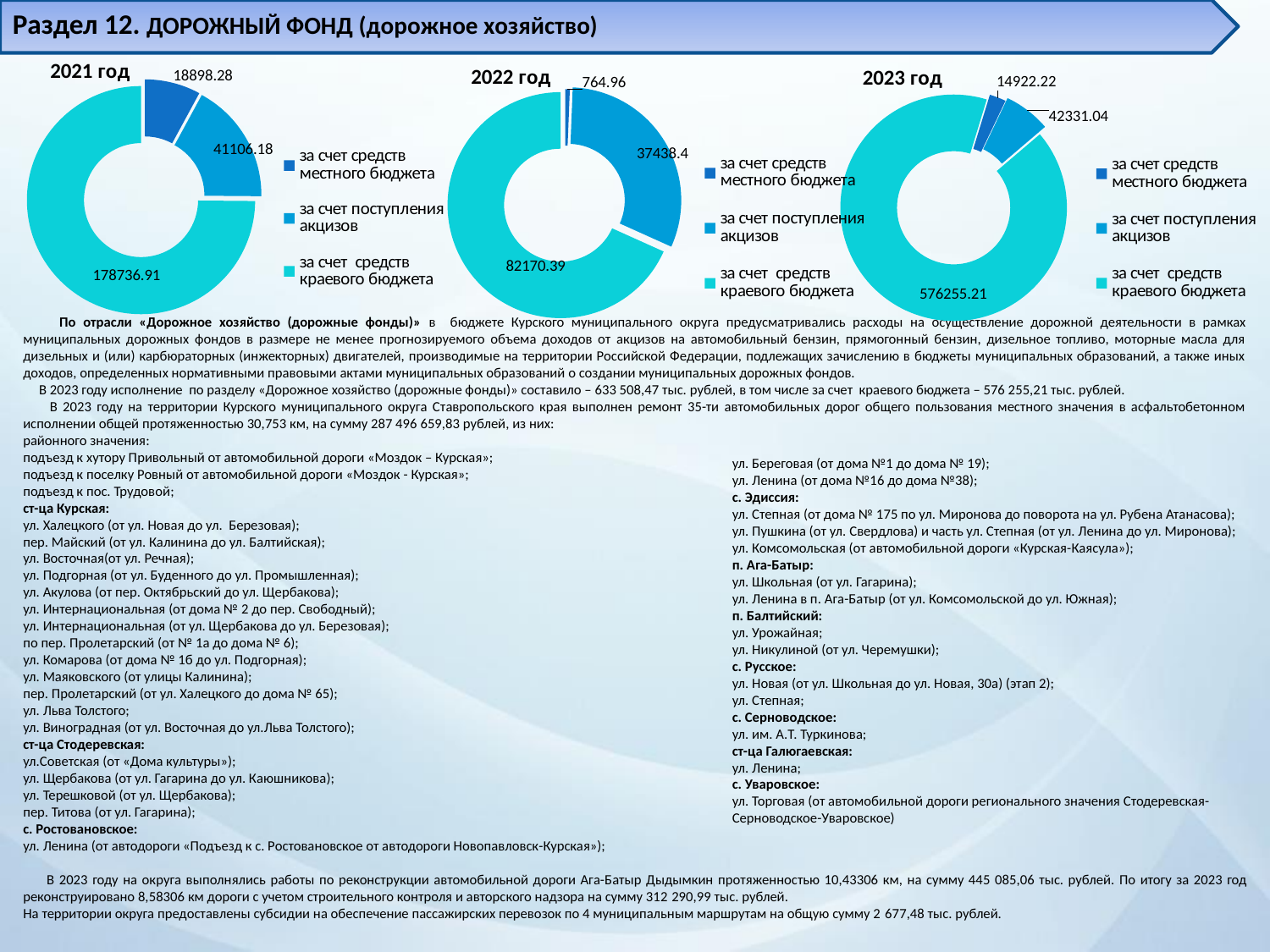
How many entries does the legend of the 2021 год chart list? 3 What kind of chart is the 2023 год chart? doughnut chart In the 2022 год chart, what is the value for за счет средств местного бюджета? 764.96 In the 2022 год chart, which category has the smallest value? за счет средств местного бюджета In the 2023 год chart, what is the value for за счет поступления акцизов? 42331.04 In the 2021 год chart, what is the difference between за счет средств краевого бюджета and за счет поступления акцизов? 137630.73 In the 2021 год chart, what is the value for за счет средств краевого бюджета? 178736.91 What is the total of all slices in the 2023 год chart? 633508.47 In the 2023 год chart, which category has the largest value? за счет средств краевого бюджета How many charts are shown on the slide? 3 How many slices does the 2022 год chart have? 3 In the 2023 год chart, which is larger: за счет средств местного бюджета or за счет поступления акцизов? за счет поступления акцизов